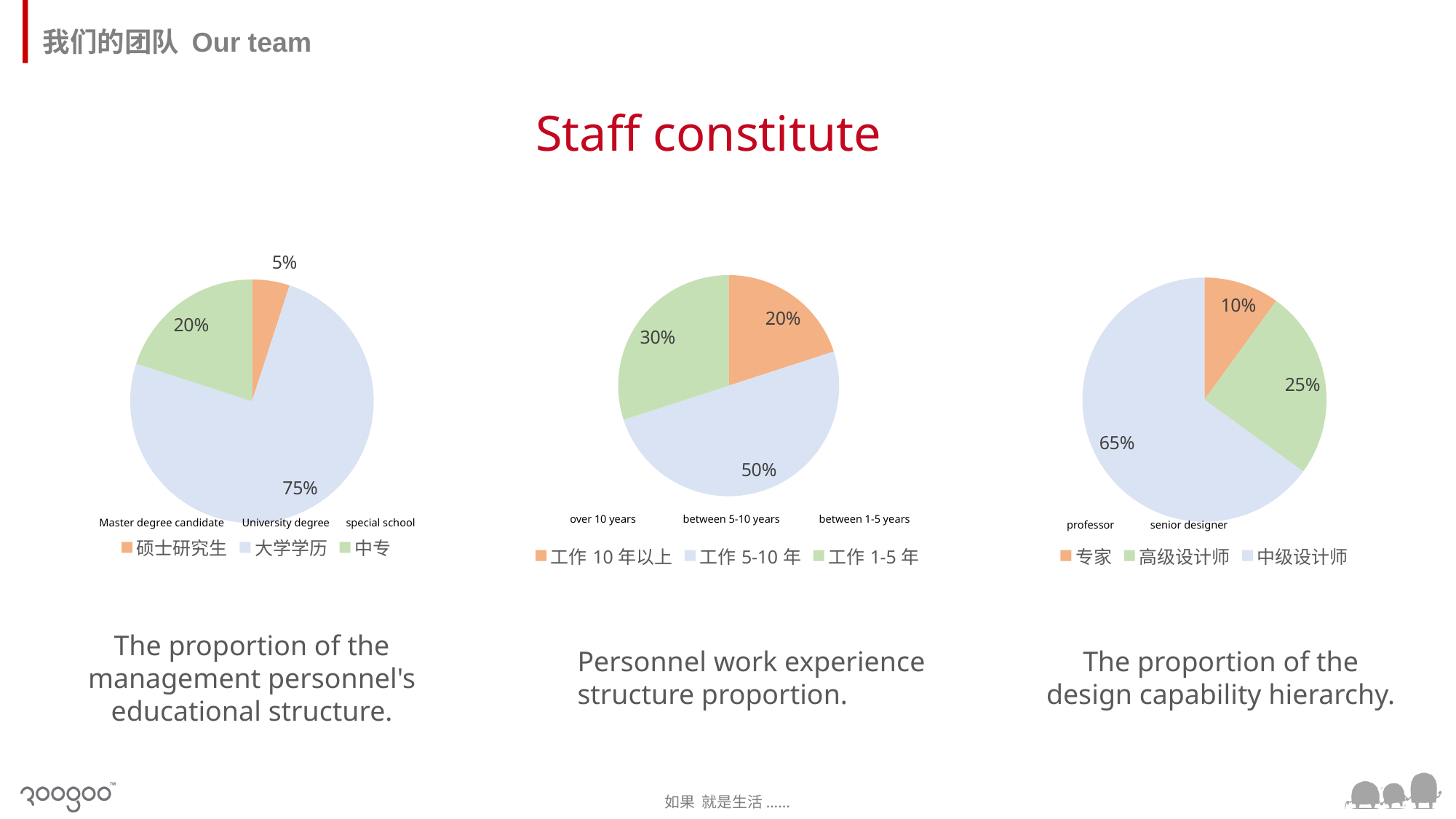
In the middle pie chart (personnel work experience structure), which is larger: between 1-5 years or over 10 years? between 1-5 years In the left pie chart (management personnel's educational structure), which category has the largest slice? University degree In the left pie chart (management personnel's educational structure), what is the difference between the special school share and the Master degree candidate share? 15% In the right pie chart (design capability hierarchy), what share is labelled for senior designer? 25% In the right pie chart (design capability hierarchy), what share is labelled for professor? 10% In the middle pie chart (personnel work experience structure), which category has the smallest slice? over 10 years In the middle pie chart (personnel work experience structure), what share is labelled for between 5-10 years? 50% In the right pie chart (design capability hierarchy), what is the difference between the largest slice (65%) and the senior designer slice? 40% What type of chart is used for all three charts on the slide? Pie chart In the left pie chart (management personnel's educational structure), what share is labelled for Master degree candidate? 5% In the middle pie chart (personnel work experience structure), how many slices does the pie have? 3 In the left pie chart (management personnel's educational structure), what share is labelled for University degree? 75%